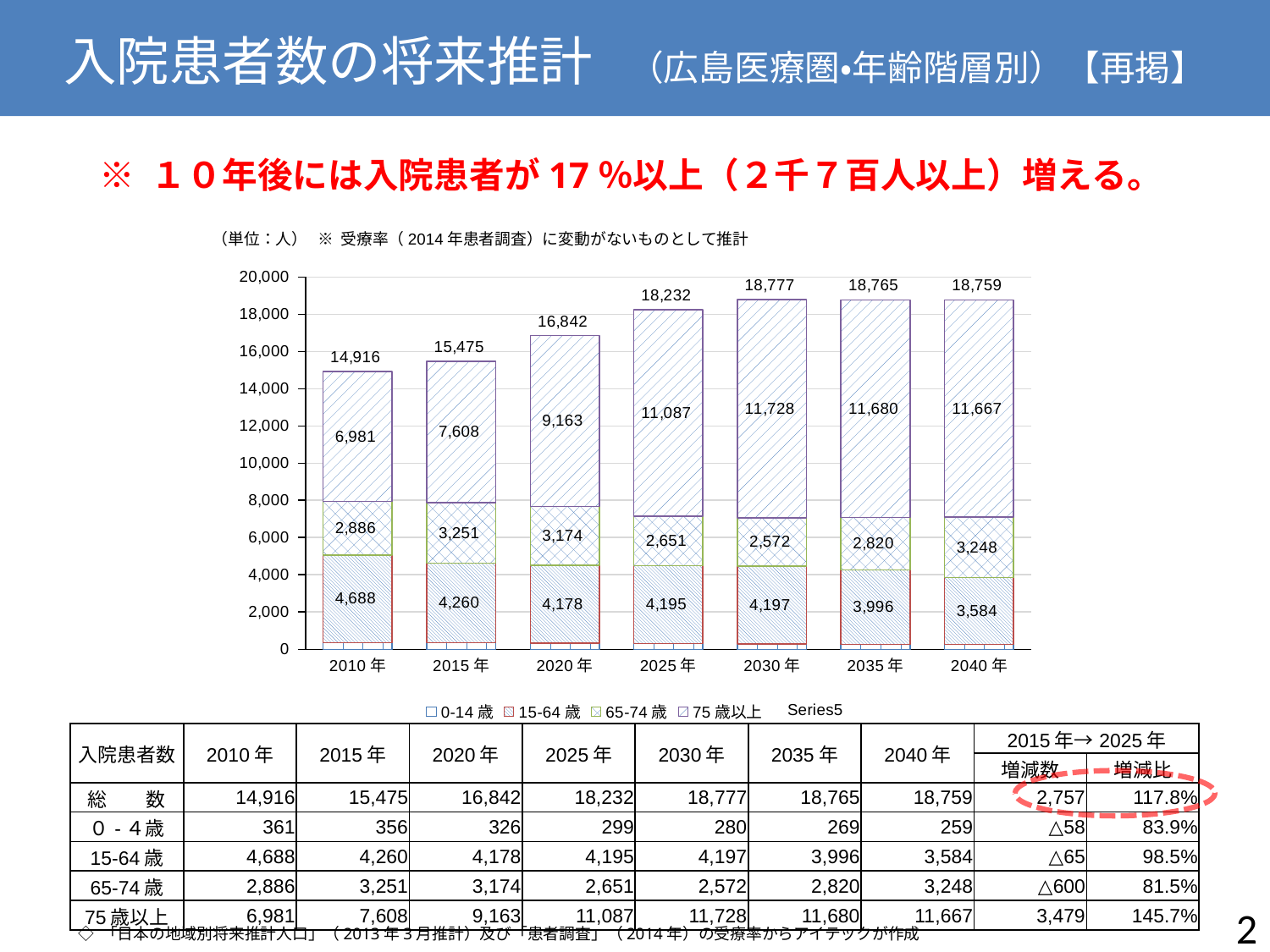
What is the value of the 75歳以上 segment for 2020年? 9,163 Which year has the highest total labeled above its bar? 2030年 Does the 15-64歳 segment rise or fall from 2010年 to 2040年? Fall What is the total value labeled above the bar for 2025年? 18,232 Which year has the lowest total labeled above its bar? 2010年 What type of chart is shown on the slide? Stacked bar chart What is the value of the 65-74歳 segment for 2015年? 3,251 How many years (categories) are shown on the x axis? 7 What is the difference between the total for 2040年 and the total for 2010年? 3,843 How many series does the legend list? 5 Which is larger, the 75歳以上 segment for 2025年 or for 2030年? 2030年 What is the value of the 15-64歳 segment for 2040年? 3,584